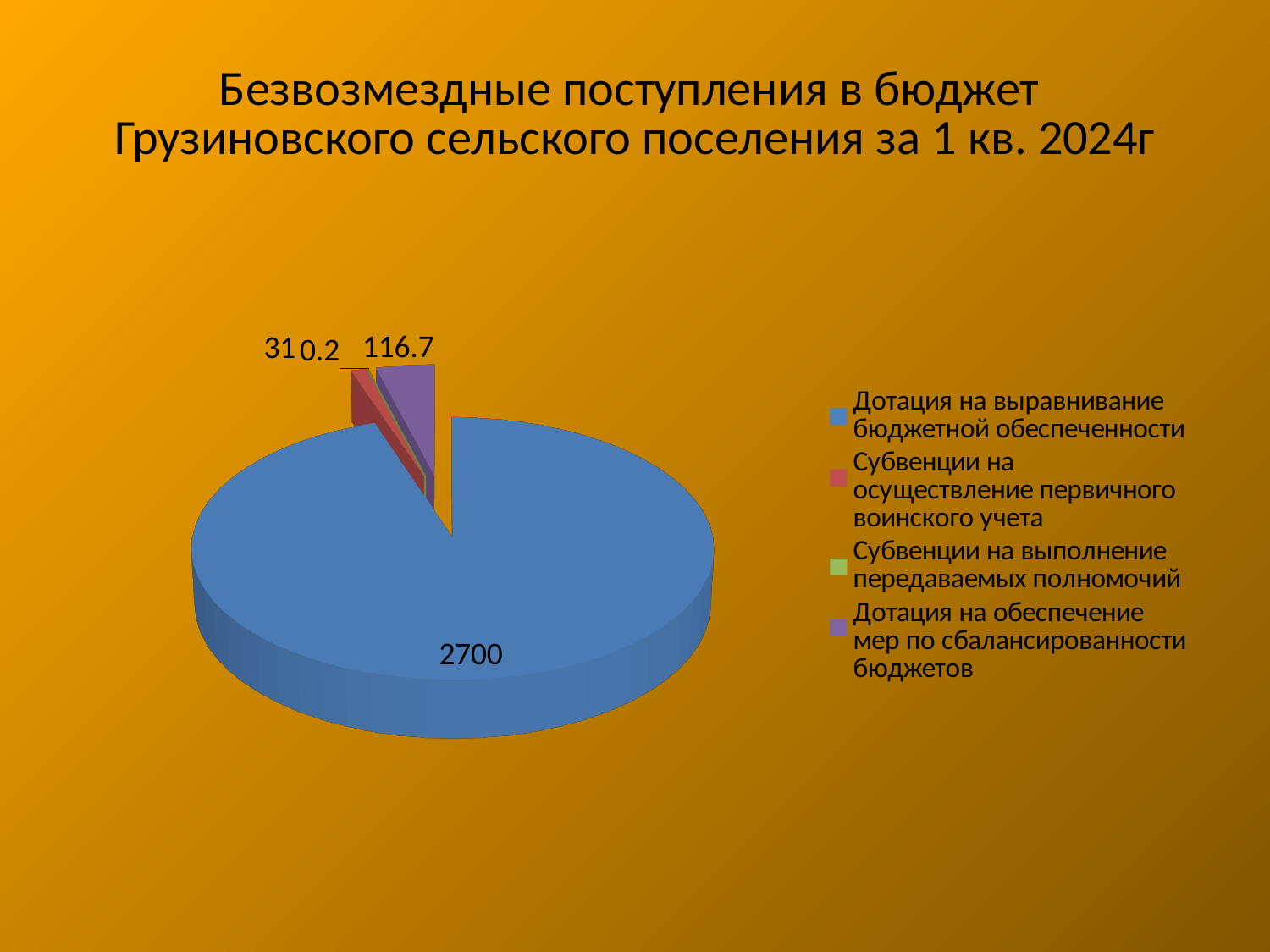
What is the value for Дотация на обеспечение мер по сбалансированности бюджетов? 116.7 How many categories does the legend list? 4 What is the difference between the value for Дотация на выравнивание бюджетной обеспеченности and the value for Дотация на обеспечение мер по сбалансированности бюджетов? 2583.3 Which category has the smallest slice of the pie? Субвенции на выполнение передаваемых полномочий What colour is the slice for Дотация на выравнивание бюджетной обеспеченности? Blue Which category has the largest slice of the pie? Дотация на выравнивание бюджетной обеспеченности What is the value for Дотация на выравнивание бюджетной обеспеченности? 2700 What is the value for Субвенции на осуществление первичного воинского учета? 31 Which is larger: the value for Субвенции на осуществление первичного воинского учета or the value for Дотация на обеспечение мер по сбалансированности бюджетов? Дотация на обеспечение мер по сбалансированности бюджетов What kind of chart is shown on the slide? Pie chart What is the difference between the value for Дотация на обеспечение мер по сбалансированности бюджетов and the value for Субвенции на осуществление первичного воинского учета? 85.7 What is the value for Субвенции на выполнение передаваемых полномочий? 0.2